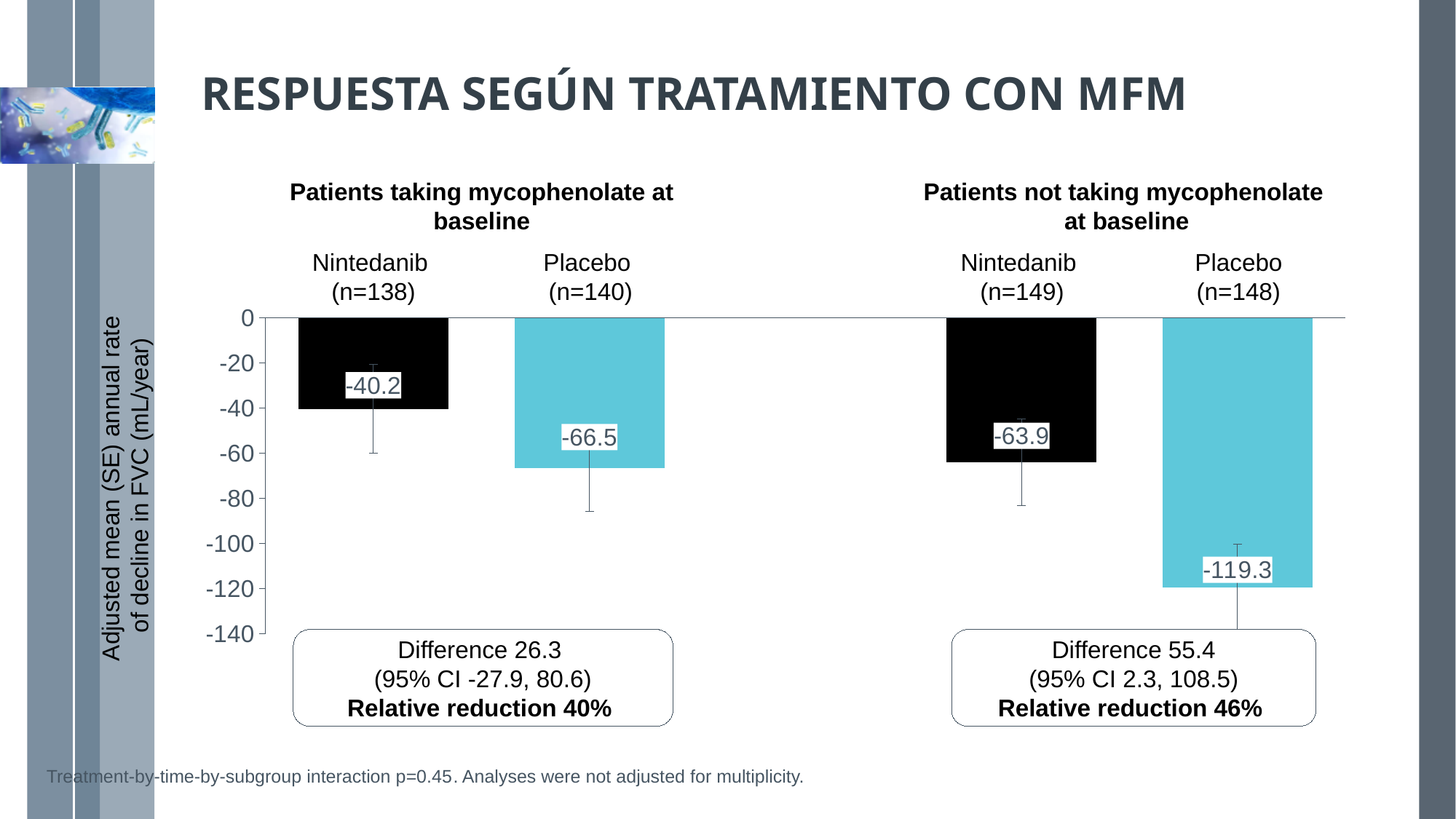
Which bar shows the smallest decline in FVC (the least negative value)? Nintedanib, patients taking mycophenolate at baseline Which shows a greater decline in FVC: Placebo in patients taking mycophenolate or Placebo in patients not taking mycophenolate? Placebo in patients not taking mycophenolate What is the difference between the Placebo and Nintedanib values among patients taking mycophenolate at baseline? 26.3 What is the adjusted mean annual rate of decline in FVC for Nintedanib among patients taking mycophenolate at baseline? -40.2 What kind of chart is shown on the slide? Bar chart What is the relative reduction reported for patients not taking mycophenolate at baseline? 46% What is the difference between the Placebo and Nintedanib values among patients not taking mycophenolate at baseline? 55.4 What is the value for Placebo among patients taking mycophenolate at baseline? -66.5 How many bars are plotted on the chart? 4 What is the value for Nintedanib among patients not taking mycophenolate at baseline? -63.9 Which bar shows the largest decline in FVC (the most negative value)? Placebo, patients not taking mycophenolate at baseline What is the value for Placebo among patients not taking mycophenolate at baseline? -119.3